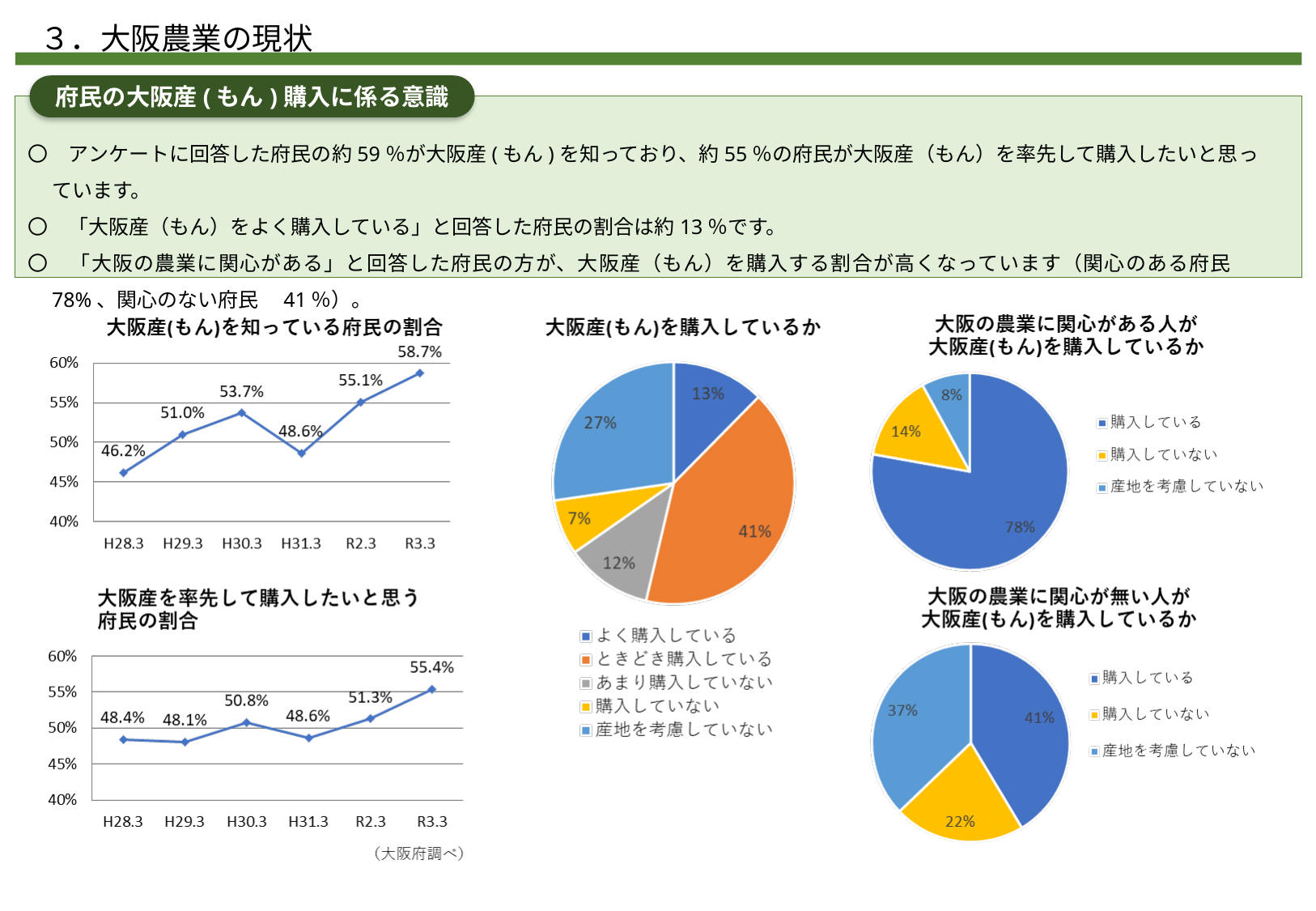
What kind of chart is the chart titled 大阪産(もん)を知っている府民の割合? Line chart In the pie chart titled 大阪の農業に関心がある人が大阪産(もん)を購入しているか, what share is 購入している? 78% In the chart titled 大阪産を率先して購入したいと思う府民の割合, what is the value for H30.3? 50.8% In the chart titled 大阪産(もん)を知っている府民の割合, which period has the lowest value? H28.3 How many periods are plotted in the chart titled 大阪産を率先して購入したいと思う府民の割合? 6 In the pie chart titled 大阪産(もん)を購入しているか, what share is ときどき購入している? 41% In the chart titled 大阪産を率先して購入したいと思う府民の割合, which period has the highest value? R3.3 In the pie chart titled 大阪の農業に関心が無い人が大阪産(もん)を購入しているか, which is larger: 購入していない or 産地を考慮していない? 産地を考慮していない In the chart titled 大阪産(もん)を知っている府民の割合, what is the difference between the values for R3.3 and H28.3? 12.5 percentage points In the chart titled 大阪産(もん)を知っている府民の割合, what is the value for R3.3? 58.7% In the pie chart titled 大阪産(もん)を購入しているか, which category has the smallest share? 購入していない In the chart titled 大阪産を率先して購入したいと思う府民の割合, is the value for H29.3 greater or less than 50%? less